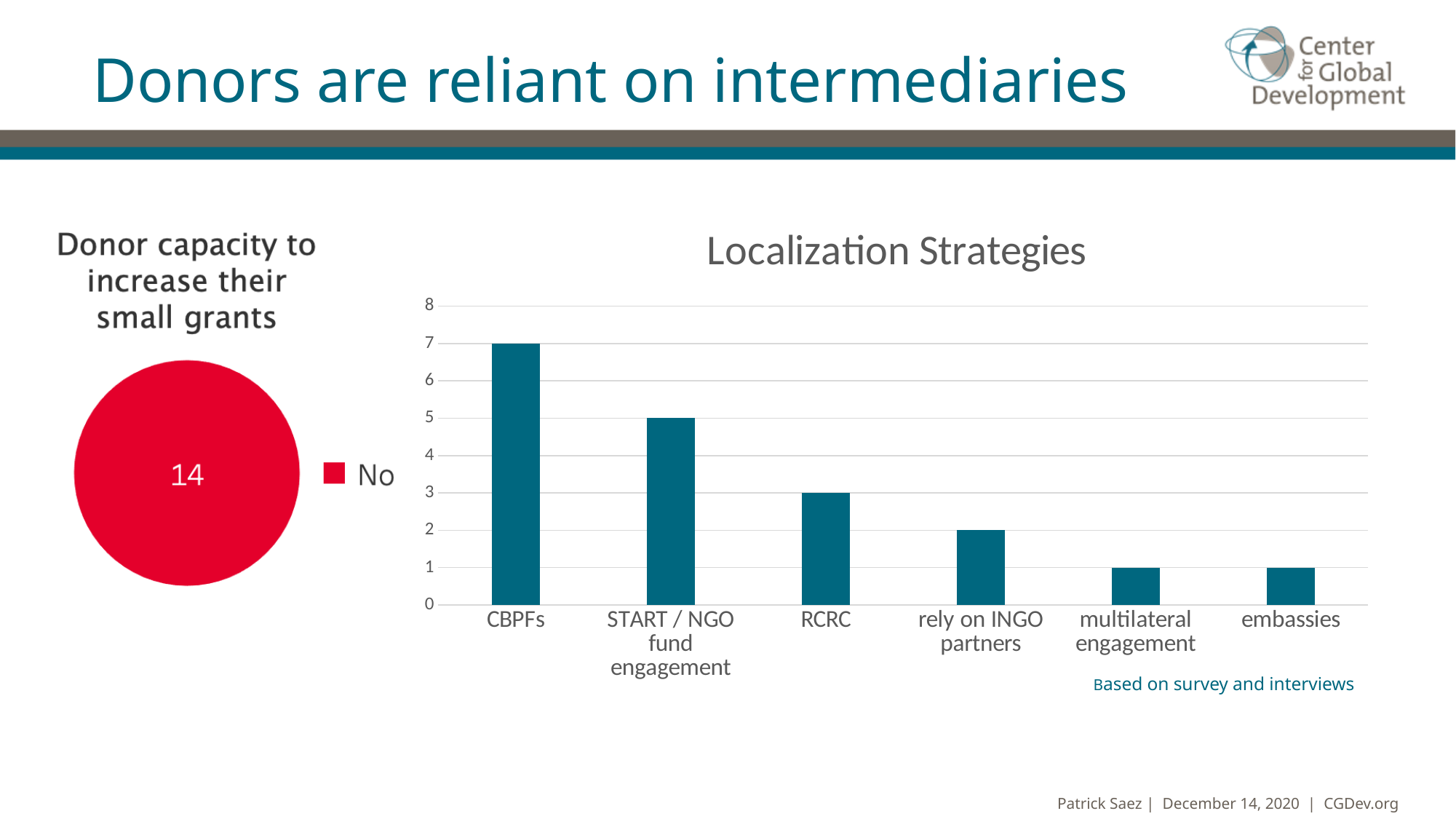
In the Localization Strategies chart, do the values rise or fall from left to right along the x axis? fall In the Localization Strategies chart, which is larger, the value for RCRC or the value for multilateral engagement? RCRC What kind of chart is the Localization Strategies chart? bar chart In the Localization Strategies chart, what is the value for rely on INGO partners? 2 In the Localization Strategies chart, what is the value for CBPFs? 7 In the Localization Strategies chart, which category has the highest value? CBPFs In the Localization Strategies chart, is the value for START / NGO fund engagement greater or less than 4? greater In the Localization Strategies chart, what is the difference between the values for CBPFs and START / NGO fund engagement? 2 In the Localization Strategies chart, what is the value for RCRC? 3 How many categories are shown in the Localization Strategies chart? 6 What kind of chart is the Donor capacity to increase their small grants chart? pie chart In the Donor capacity to increase their small grants chart, what value is shown for No? 14